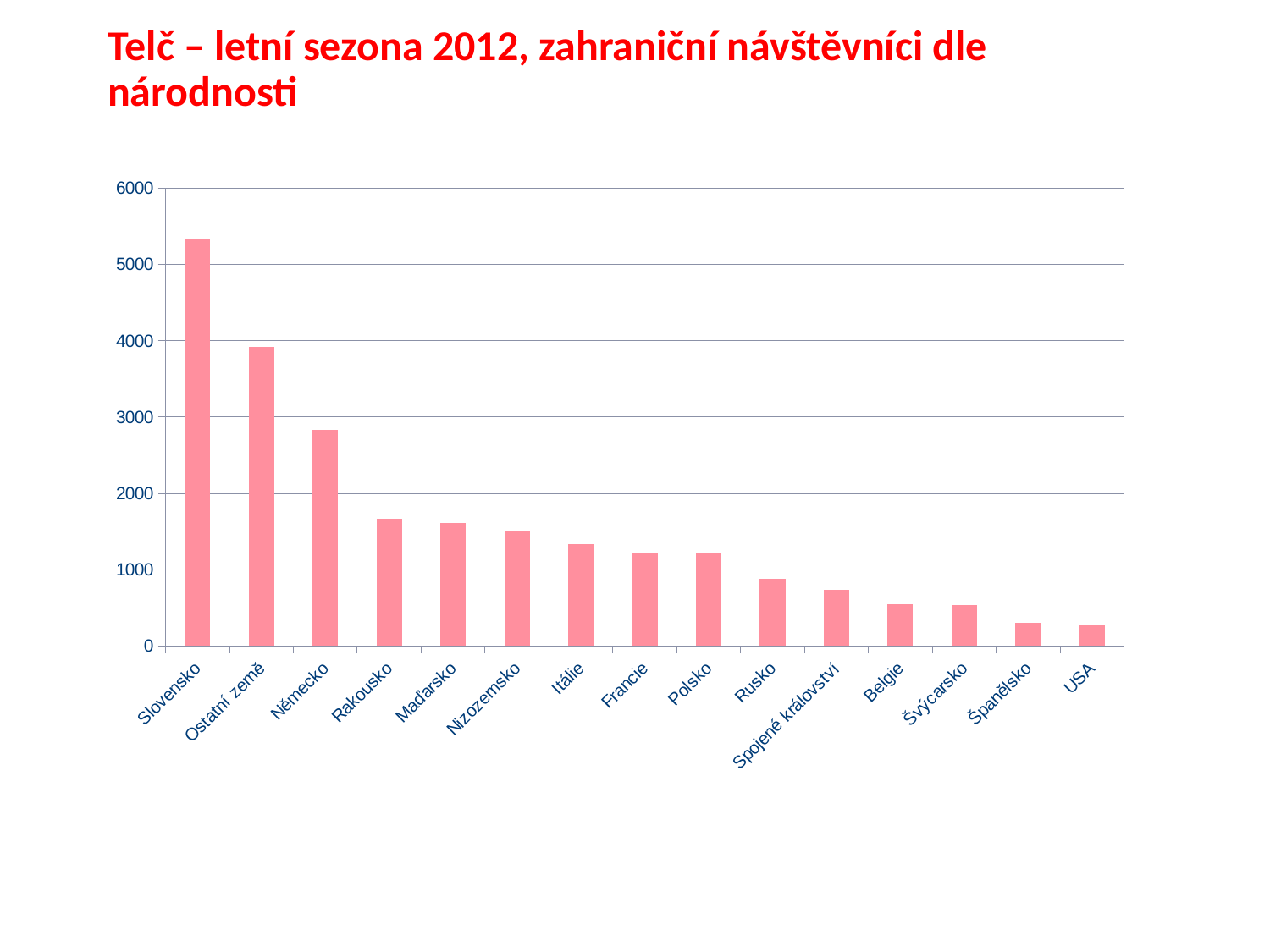
What kind of chart is shown on the slide? bar chart Which is larger, the value for Rusko or the value for Spojené království? Rusko What is the title of the slide containing the chart? Telč – letní sezona 2012, zahraniční návštěvníci dle národnosti Is the value for Rusko greater or less than 1000? less Is the value for Rakousko greater or less than 1000? greater Is the value for Německo greater or less than 3000? less Which is larger, the value for Německo or the value for Rakousko? Německo Do the values rise or fall moving from left to right along the x axis? fall How many nationality categories are shown on the x axis? 15 Which category has the highest value? Slovensko